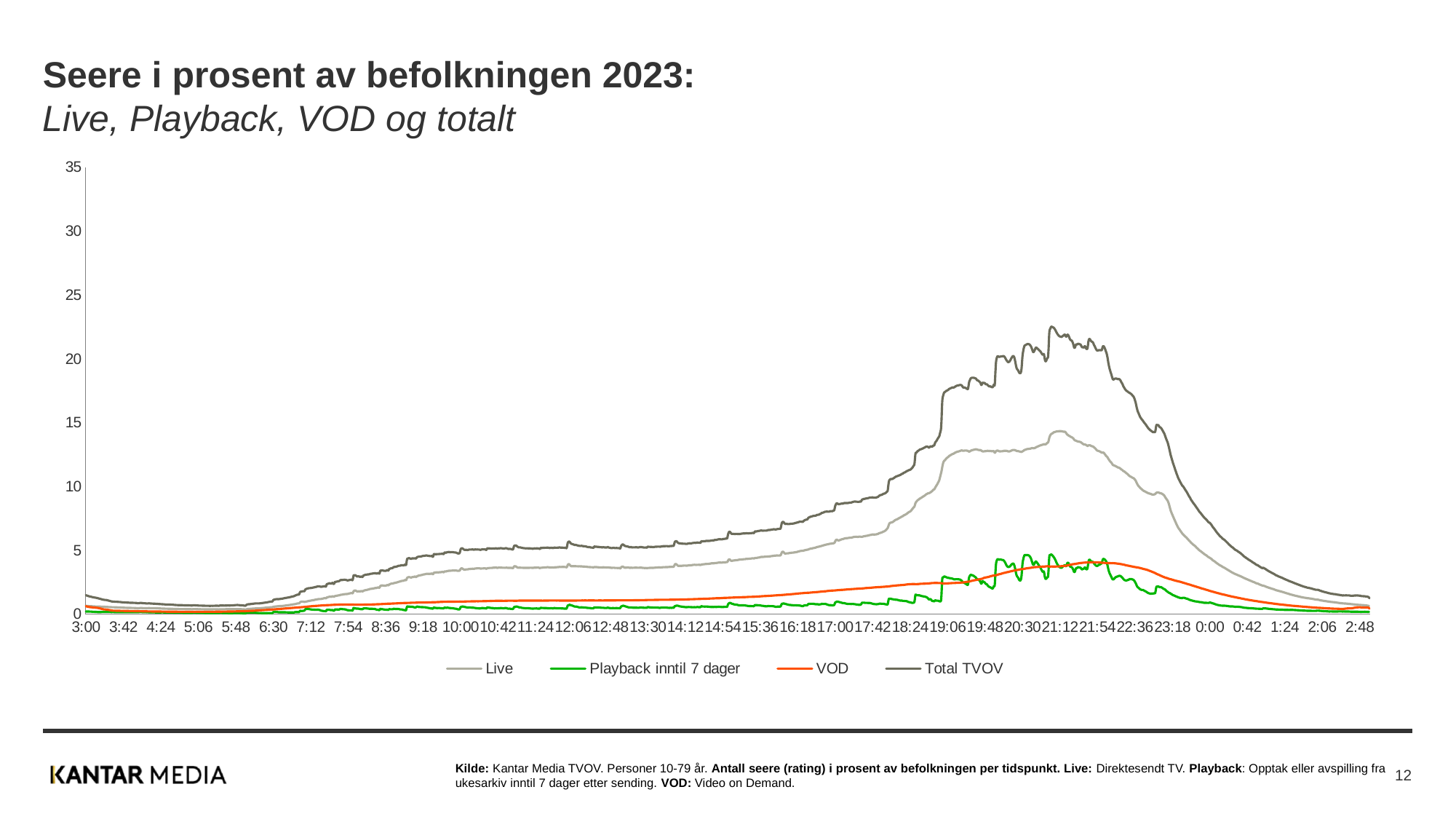
What kind of chart is shown on the slide? Line chart Is the peak value of Live greater or less than 10? greater How many series does the legend list? 4 Which series is listed second in the legend? Playback inntil 7 dager What colour is the VOD line? Orange Is the value of Live at 12:06 greater or less than 5? less Is the peak value of Total TVOV greater or less than 20? greater Which is larger at 21:12, Total TVOV or Live? Total TVOV Which series reaches the highest value on the chart? Total TVOV Does the Total TVOV line rise or fall between 21:12 and 2:48? Fall Which series has the lowest value at 3:00? Playback inntil 7 dager